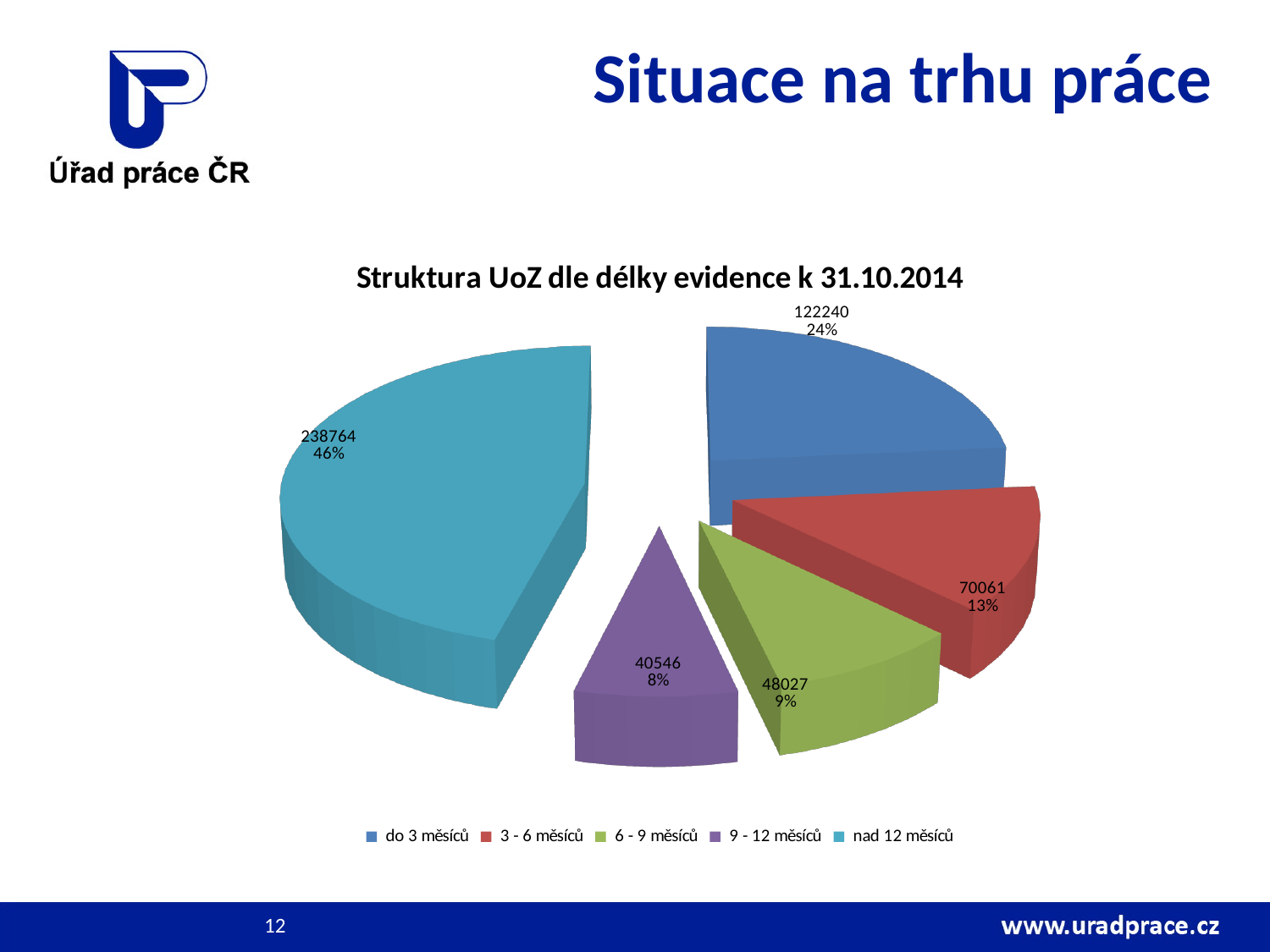
Which is larger, the value for '3 - 6 měsíců' or '6 - 9 měsíců'? 3 - 6 měsíců What is the value for 'do 3 měsíců'? 122240 What is the title of the chart? Struktura UoZ dle délky evidence k 31.10.2014 How many slices does the pie chart have? 5 What is the value for '6 - 9 měsíců'? 48027 What share of the pie does '3 - 6 měsíců' represent? 13% What is the difference between the values for 'nad 12 měsíců' and 'do 3 měsíců'? 116524 What kind of chart is shown on the slide? pie chart What is the value for 'nad 12 měsíců'? 238764 Which category has the smallest slice? 9 - 12 měsíců Which category has the largest slice? nad 12 měsíců What share of the pie does '9 - 12 měsíců' represent? 8%